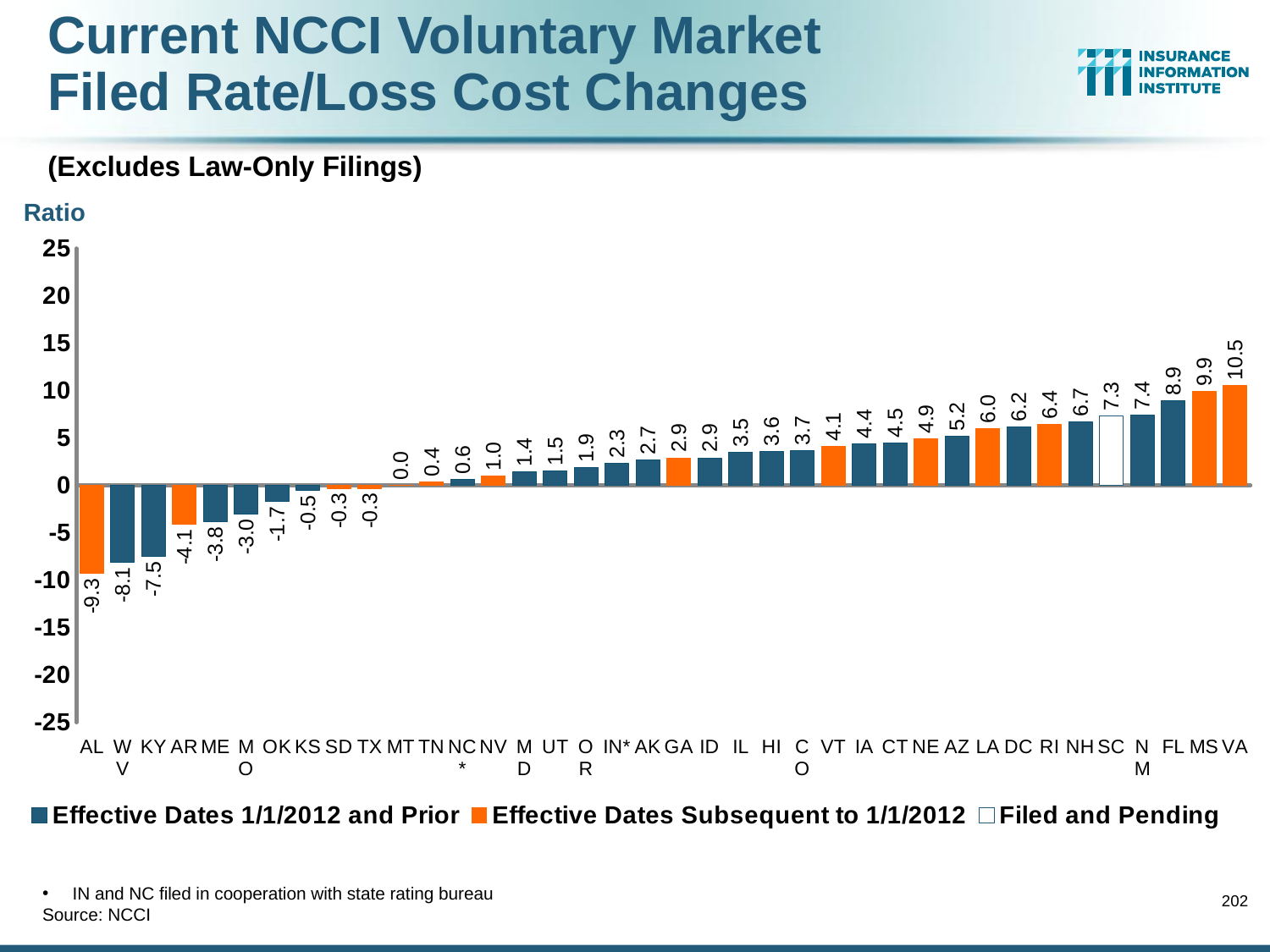
Which state has the lowest value? AL What is the difference between the values for VA and MS? 0.6 How many states are shown on the x axis? 38 Which legend entry does the white (unfilled) bar for SC represent? Filed and Pending Is the value for KY greater or less than -5? less What is the value for VA? 10.5 Which has a larger value, FL or NH? FL What is the value for AL? -9.3 Which state has the highest value? VA What kind of chart is this? Bar chart What is the value for SC? 7.3 How many series does the legend list? 3